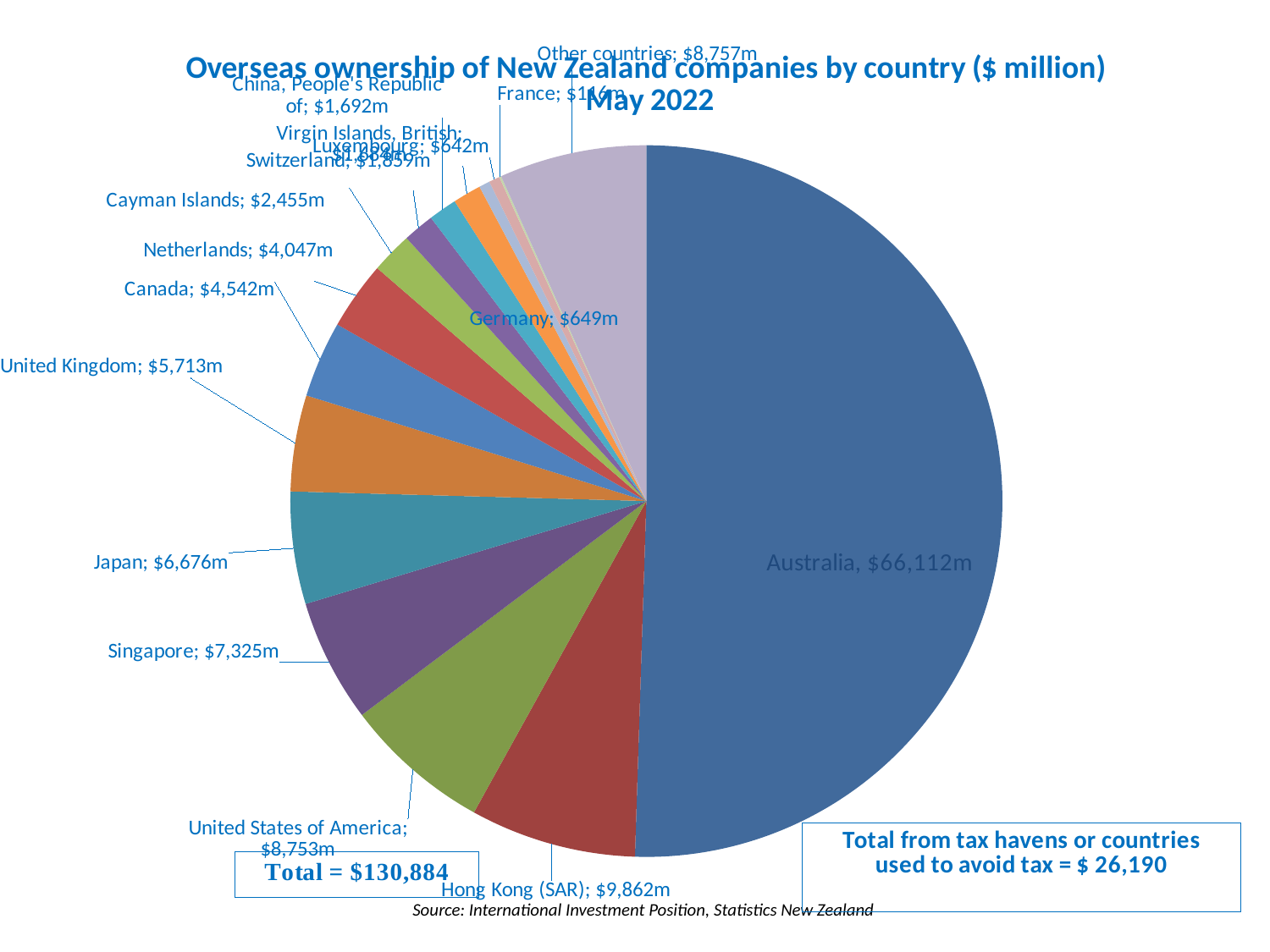
According to the text box on the slide, what is the total from tax havens or countries used to avoid tax? $ 26,190 What is the value shown for Singapore? $7,325m What is the title of the chart? Overseas ownership of New Zealand companies by country ($ million) May 2022 What is the value shown for Australia? $66,112m Which country has the largest slice of the pie? Australia What is the value shown for Hong Kong (SAR)? $9,862m What is the difference between the values for Japan and the United Kingdom? $963m What is the value shown for the Netherlands? $4,047m What is the value shown for the Cayman Islands? $2,455m What kind of chart is shown on the slide? Pie chart What is the difference between the values for Hong Kong (SAR) and the United States of America? $1,109m Which is larger, the value for Singapore or the value for Japan? Singapore